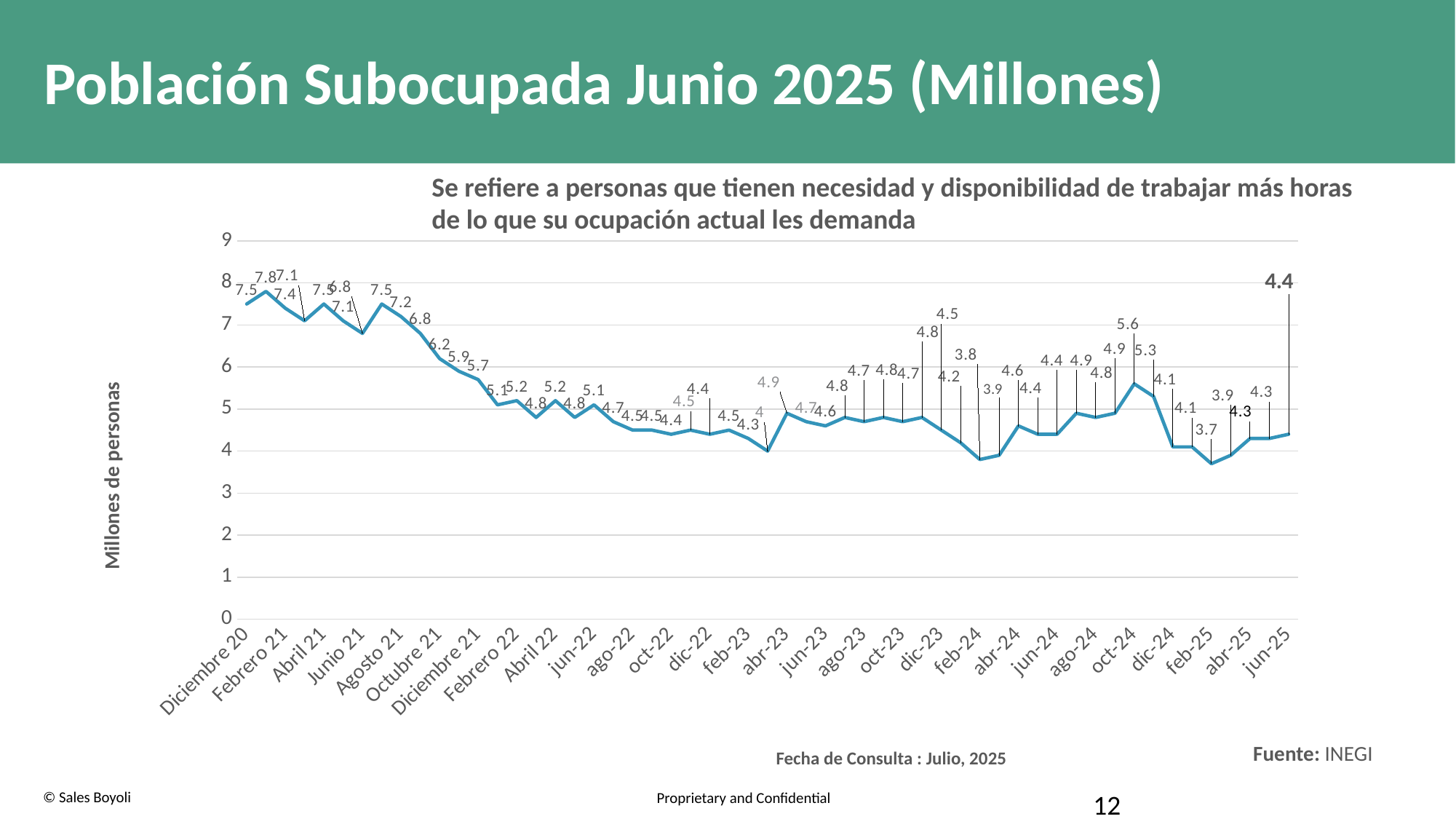
What is the value for Diciembre 20? 7.5 Is the value for Diciembre 20 greater or less than 7? greater What is the value for feb-25? 3.7 What kind of chart is shown on the slide? line chart What is the value for oct-24? 5.6 What is the difference between the value for Diciembre 20 and the value for jun-25? 3.1 Which is larger, the value for oct-24 or the value for jun-25? oct-24 Overall, do the values rise or fall from Diciembre 20 to jun-25? fall What is the lowest value plotted on the chart? 3.7 What is the value for jun-25? 4.4 What is the label of the vertical axis? Millones de personas What is the highest value plotted on the chart? 7.8